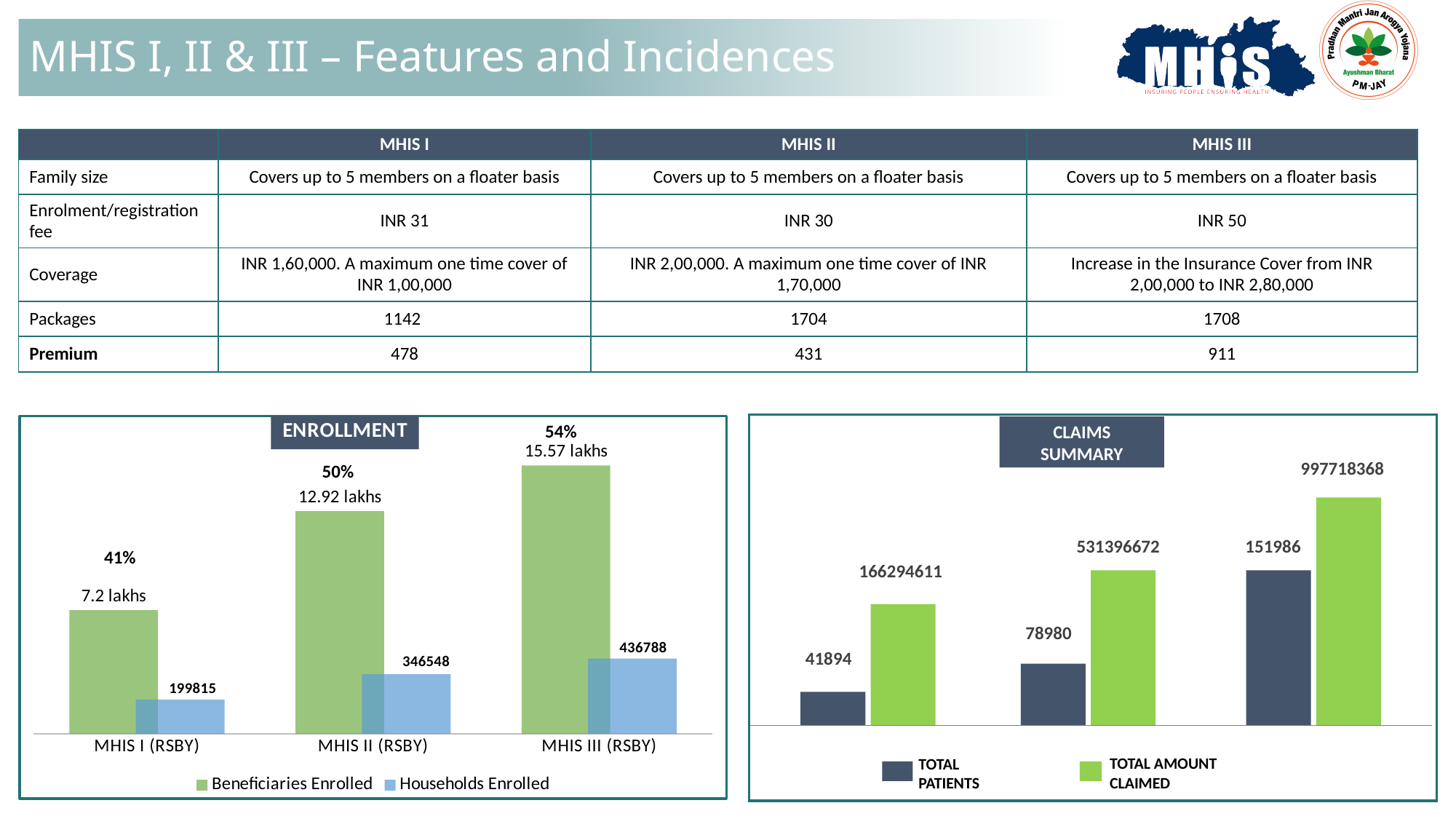
What kind of chart is the Claims Summary chart? bar chart In the Enrollment chart, how many series does the legend list? 2 In the Claims Summary chart, which series is shown in green? Total Amount Claimed In the Enrollment chart, what is the value of Households Enrolled for MHIS II (RSBY)? 346548 In the Enrollment chart, what percentage is shown above the MHIS I (RSBY) Beneficiaries Enrolled bar? 41% In the Claims Summary chart, what is the lowest Total Patients value shown? 41894 In the Enrollment chart, do the Beneficiaries Enrolled values rise or fall from MHIS I (RSBY) to MHIS III (RSBY)? rise In the Claims Summary chart, what is the highest Total Amount Claimed value shown? 997718368 In the Enrollment chart, which category has the highest Households Enrolled value? MHIS III (RSBY) In the Enrollment chart, which category has the lowest Beneficiaries Enrolled value? MHIS I (RSBY) In the Enrollment chart, what is the value of Beneficiaries Enrolled for MHIS III (RSBY)? 15.57 lakhs In the Enrollment chart, what is the difference in Households Enrolled between MHIS III (RSBY) and MHIS I (RSBY)? 236973